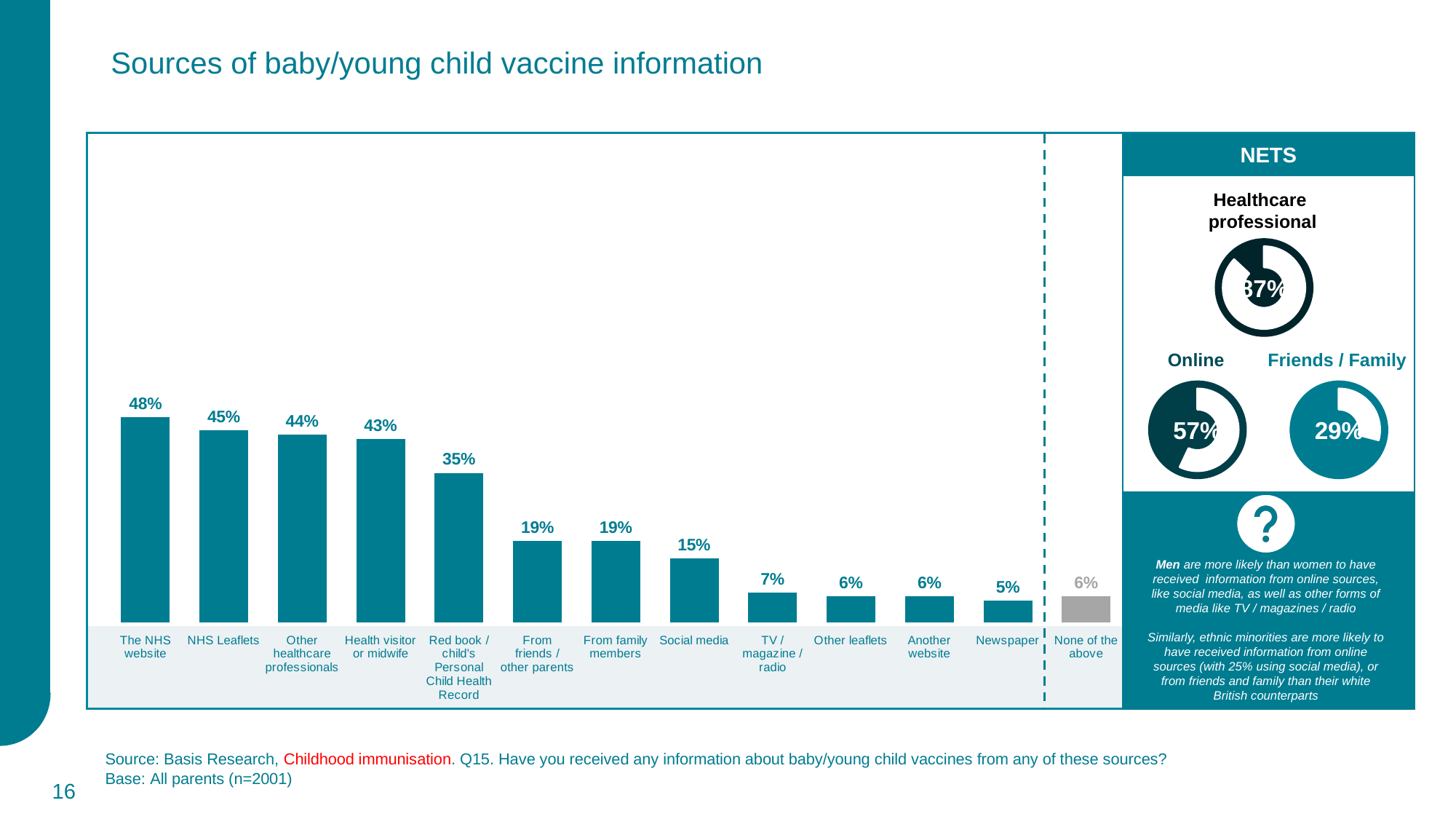
In the bar chart, what is the value for Social media? 15% In the bar chart, what is the value for Red book / child's Personal Child Health Record? 35% In the bar chart, which is larger: From family members or Social media? From family members What type of chart is used to show the sources of baby/young child vaccine information? Bar chart How many categories are shown in the bar chart? 13 In the bar chart, what is the difference between The NHS website and NHS Leaflets? 3 percentage points In the bar chart, which source has the lowest value? Newspaper In the NETS panel, what is the value shown for Friends / Family? 29% In the bar chart, what percentage of parents received information from The NHS website? 48% In the NETS panel, what is the value shown for Online? 57% In the bar chart, which source has the highest value? The NHS website In the bar chart, do the values rise or fall from left to right across the sources before the dashed line? Fall